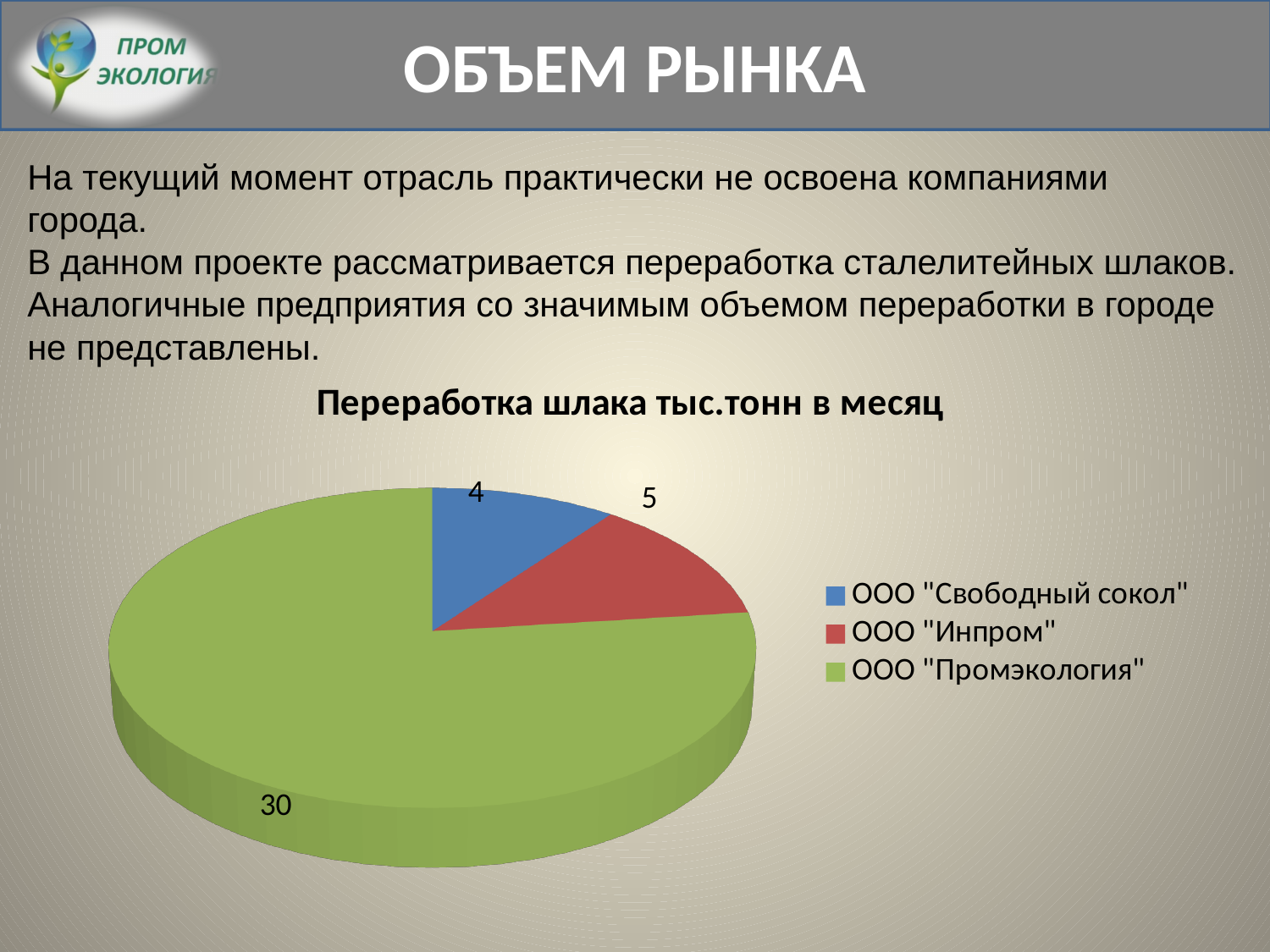
Which is larger, the value for ООО "Инпром" or for ООО "Свободный сокол"? ООО "Инпром" What is the value for ООО "Инпром"? 5 What type of chart is shown on the slide? pie chart What is the value for ООО "Свободный сокол"? 4 Which company has the largest slice of the pie? ООО "Промэкология" What is the difference between the values for ООО "Промэкология" and ООО "Инпром"? 25 What is the title of the chart? Переработка шлака тыс.тонн в месяц Which company has the smallest slice of the pie? ООО "Свободный сокол" What is the total of all three values in the pie chart? 39 What is the value for ООО "Промэкология"? 30 How many slices does the pie chart have? 3 How many entries does the legend list? 3